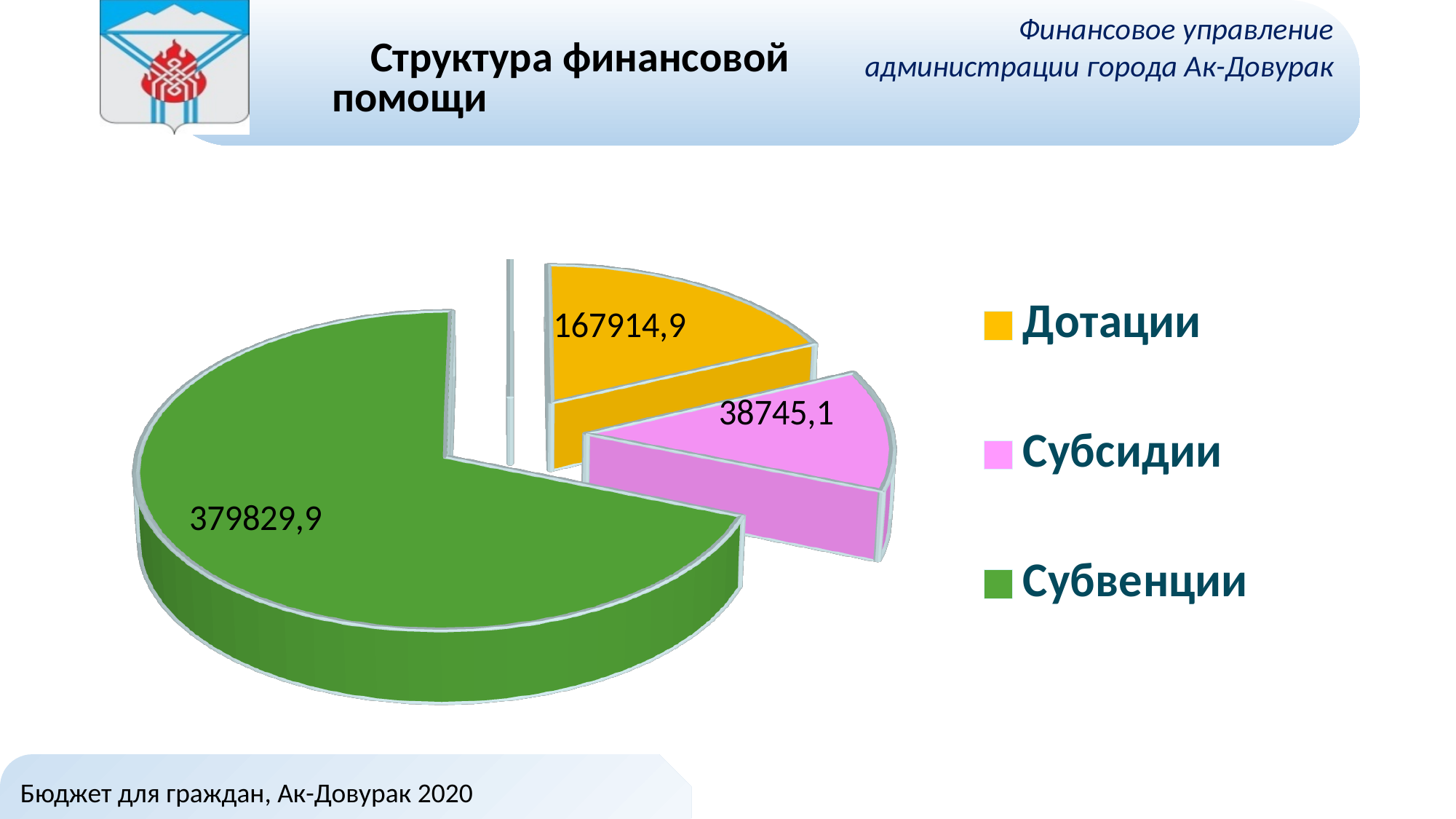
What is the total of all three slices? 586489,9 What is the value for Субсидии? 38745,1 What is the value for Субвенции? 379829,9 What kind of chart is shown on the slide? Pie chart Which is larger, the value for Дотации or the value for Субсидии? Дотации What is the difference between the values for Дотации and Субсидии? 129169,8 How many slices does the pie chart have? 3 Which category has the largest slice of the pie? Субвенции What is the title of the chart? Структура финансовой помощи Which category has the smallest slice of the pie? Субсидии What is the difference between the values for Субвенции and Дотации? 211915,0 What is the value for Дотации? 167914,9